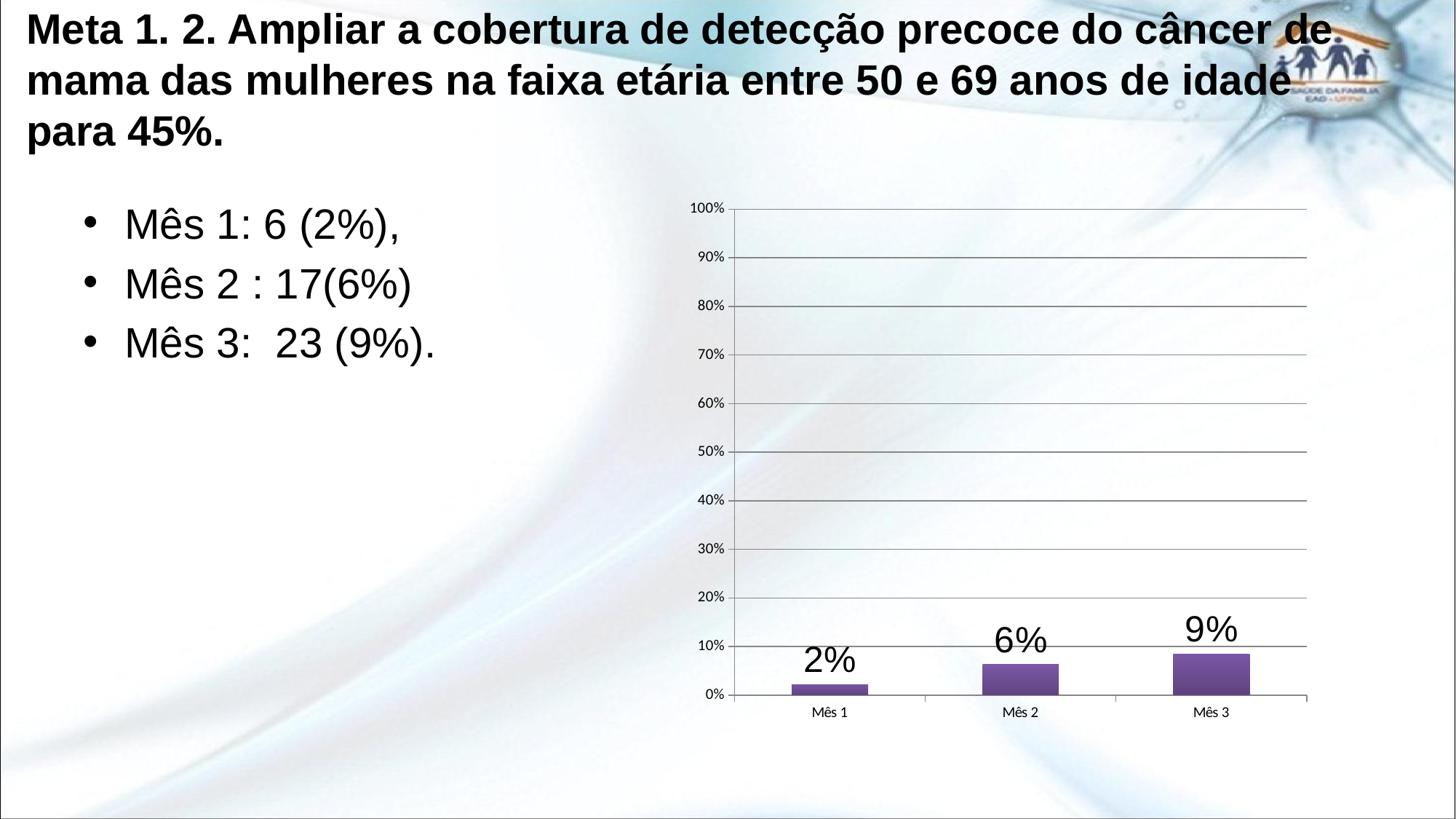
How many categories are shown on the x axis of the chart? 3 Which month has the lowest value in the chart? Mês 1 What is the difference between the values for Mês 2 and Mês 1? 4% What is the difference between the values for Mês 3 and Mês 1? 7% Do the values rise or fall from Mês 1 to Mês 3? rise What is the value for Mês 2 in the chart? 6% What is the value for Mês 3 in the chart? 9% What is the value for Mês 1 in the chart? 2% Is the value for Mês 3 greater or less than 10%? less Which is larger, the value for Mês 2 or the value for Mês 3? Mês 3 What kind of chart is shown on the slide? bar chart Which month has the highest value in the chart? Mês 3